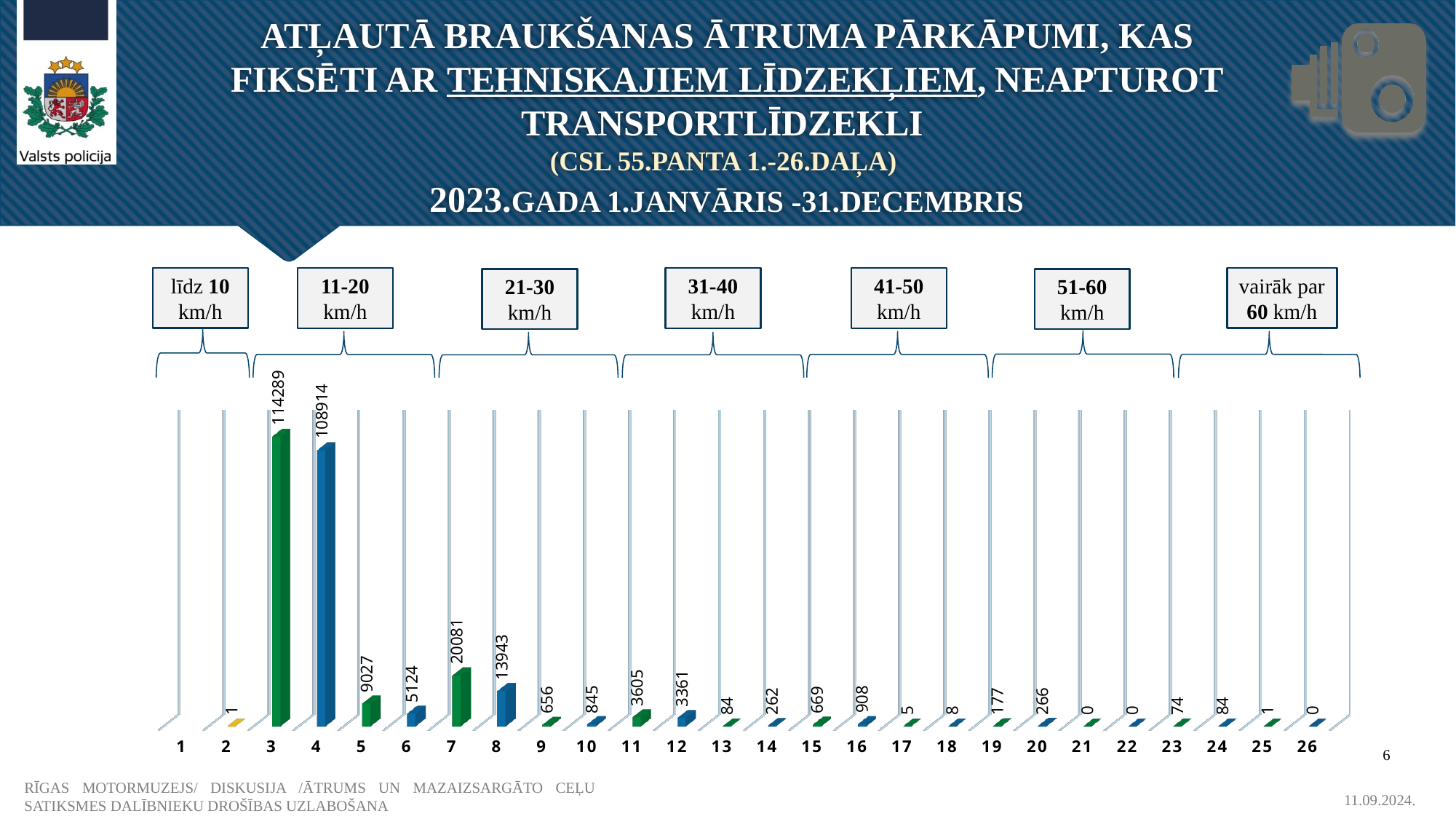
What is the value for category 19? 177 What is the value for category 3? 114289 Which is larger, the value for category 5 or category 6? category 5 What is the value for category 12? 3361 What is the value for category 4? 108914 What is the value for category 7? 20081 How many speed-range group labels (km/h) are shown above the chart? 7 How many numbered categories are shown on the x axis? 26 What is the difference between the values for categories 3 and 4? 5375 Which category has the highest value? 3 What kind of chart is shown on the slide? bar chart What is the difference between the values for categories 7 and 8? 6138